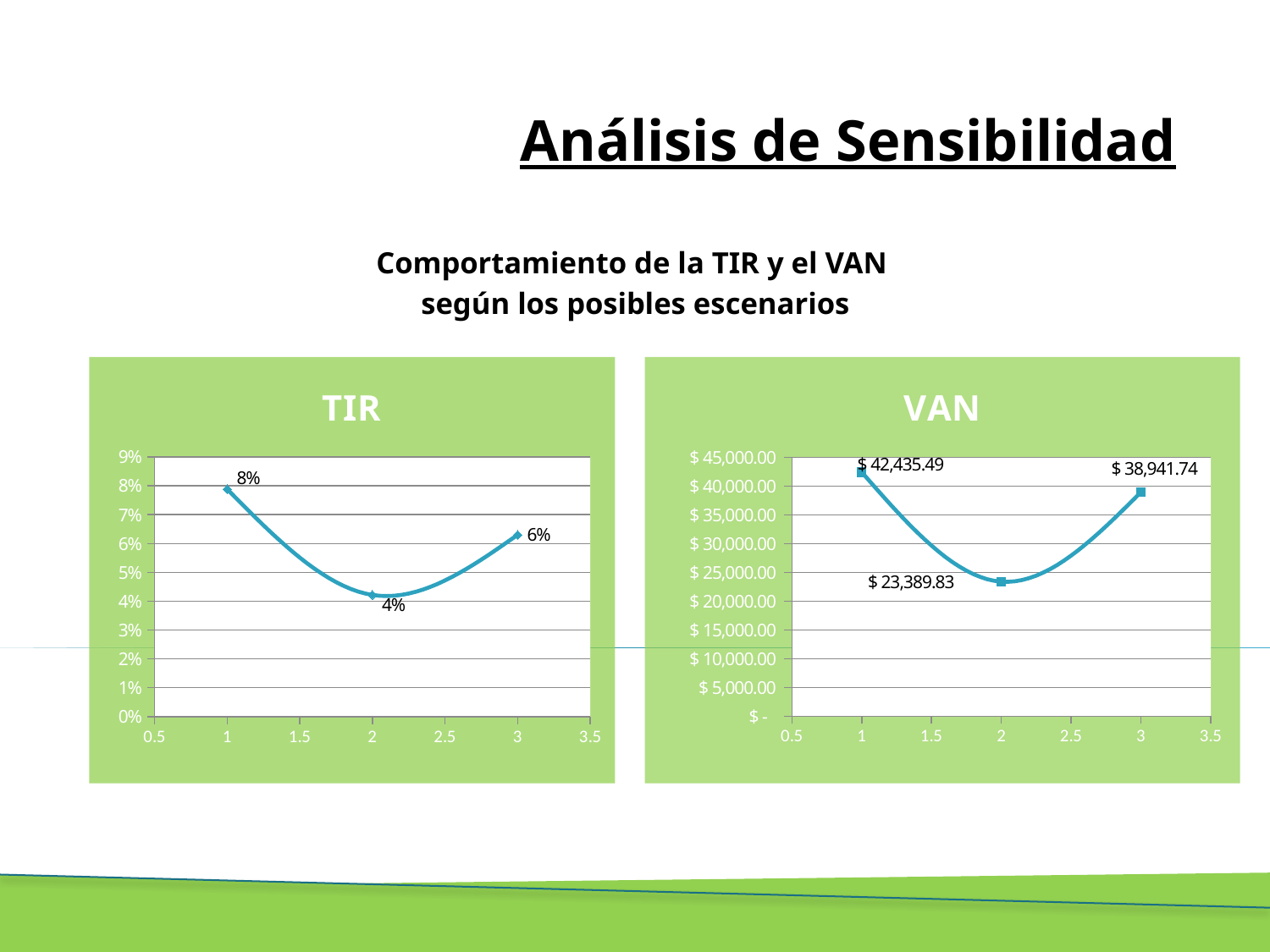
How many data points are plotted in the VAN chart? 3 In the VAN chart, what is the value at x = 2? $ 23,389.83 In the VAN chart, at which x value is the VAN highest? 1 In the VAN chart, what is the difference between the values at x = 1 and x = 3? $ 3,493.75 In the TIR chart, what is the value at x = 3? 6% In the TIR chart, what is the difference between the values at x = 1 and x = 2? 4% In the VAN chart, what is the value at x = 3? $ 38,941.74 In the TIR chart, what is the value at x = 1? 8% In the VAN chart, what is the value at x = 1? $ 42,435.49 In the TIR chart, at which x value is the TIR lowest? 2 In the VAN chart, which is larger, the value at x = 3 or the value at x = 2? x = 3 In the TIR chart, what is the value at x = 2? 4%